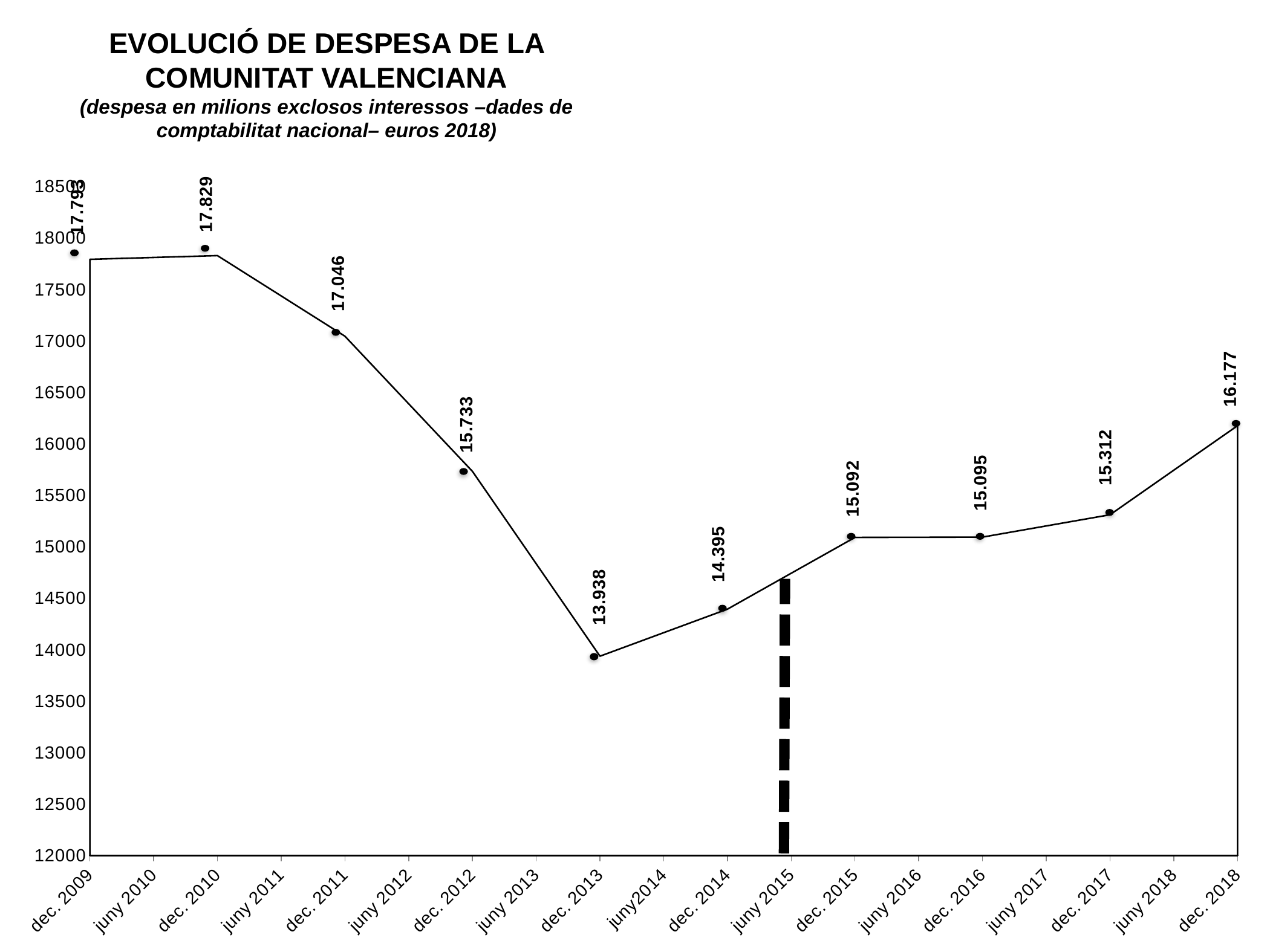
What is the value for dec. 2011? 17.046 What is the value for dec. 2013? 13.938 What type of chart is shown on the slide? line chart At which x-axis label is the thick dashed vertical line drawn? juny 2015 What is the value for dec. 2015? 15.092 Which date has the lowest value? dec. 2013 How many data points are plotted on the line? 10 Which is larger, the value for dec. 2017 or the value for dec. 2018? dec. 2018 What is the value for dec. 2018? 16.177 Do the values rise or fall from dec. 2010 to dec. 2013? fall Is the value for dec. 2014 greater or less than 14500? less What is the difference between the values for dec. 2012 and dec. 2013? 1.795